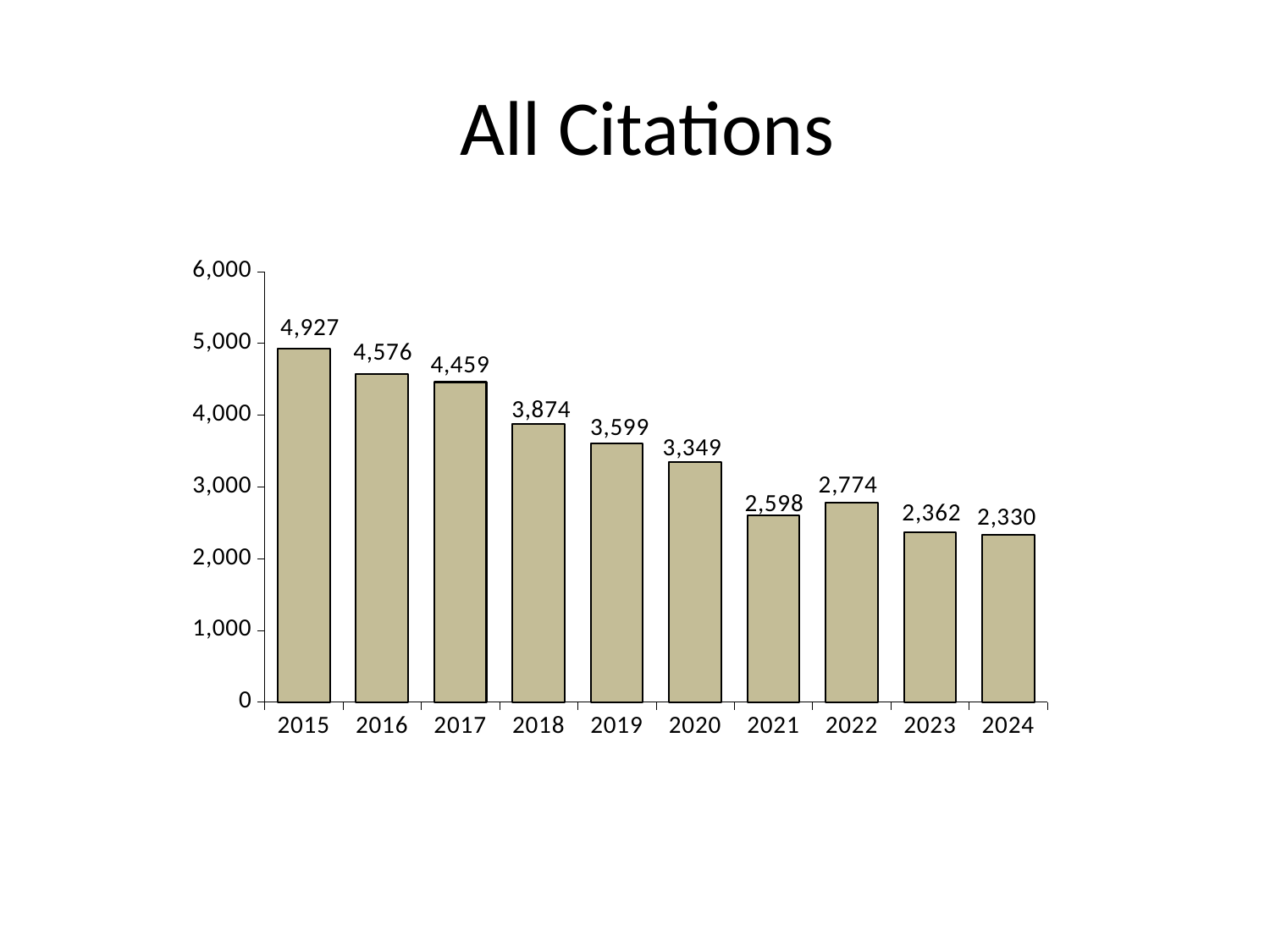
Which year has the highest value? 2015 What kind of chart is this? bar chart Which is larger, the value for 2018 or the value for 2019? 2018 What is the value for 2020? 3,349 Which year has the lowest value? 2024 What is the value for 2024? 2,330 Is the value for 2017 greater or less than 4,000? greater What is the title of the chart? All Citations What is the difference between the values for 2015 and 2024? 2,597 What is the difference between the values for 2021 and 2022? 176 What is the value for 2015? 4,927 How many years are shown on the x axis? 10